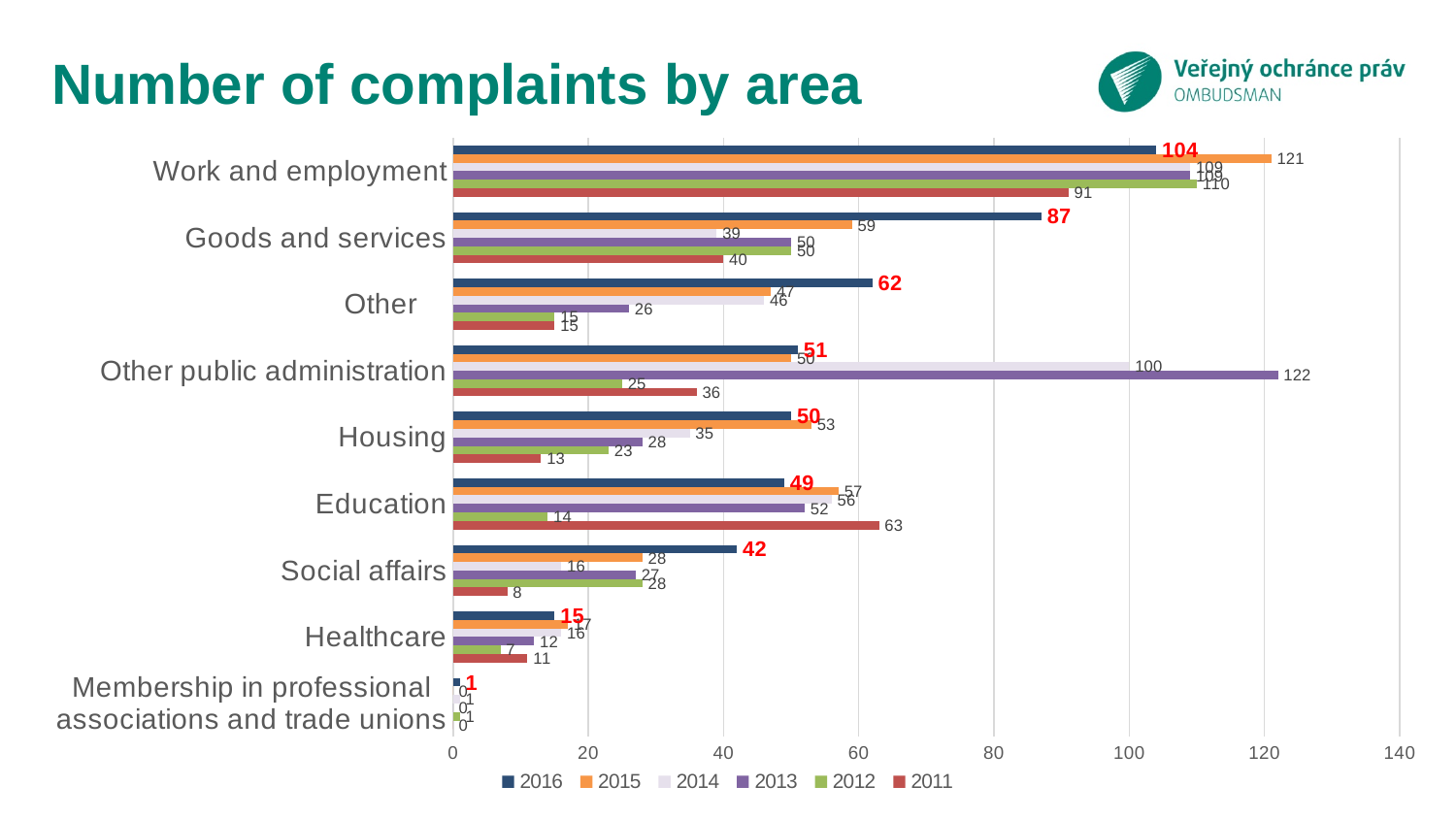
In the Education category, which is larger: the value for 2011 or the value for 2015? 2011 How many categories are shown on the chart? 9 What is the title of the chart? Number of complaints by area What is the difference between the 2016 values for Work and employment and Goods and services? 17 What is the value for 2015 in the Work and employment category? 121 What is the value for 2011 in the Housing category? 13 How many series does the legend list? 6 Which category has the highest value for 2016? Work and employment What kind of chart is shown on the slide? Bar chart What is the value for 2016 in the Goods and services category? 87 Which category has the lowest value for 2016? Membership in professional associations and trade unions What is the value for 2013 in the Other public administration category? 122